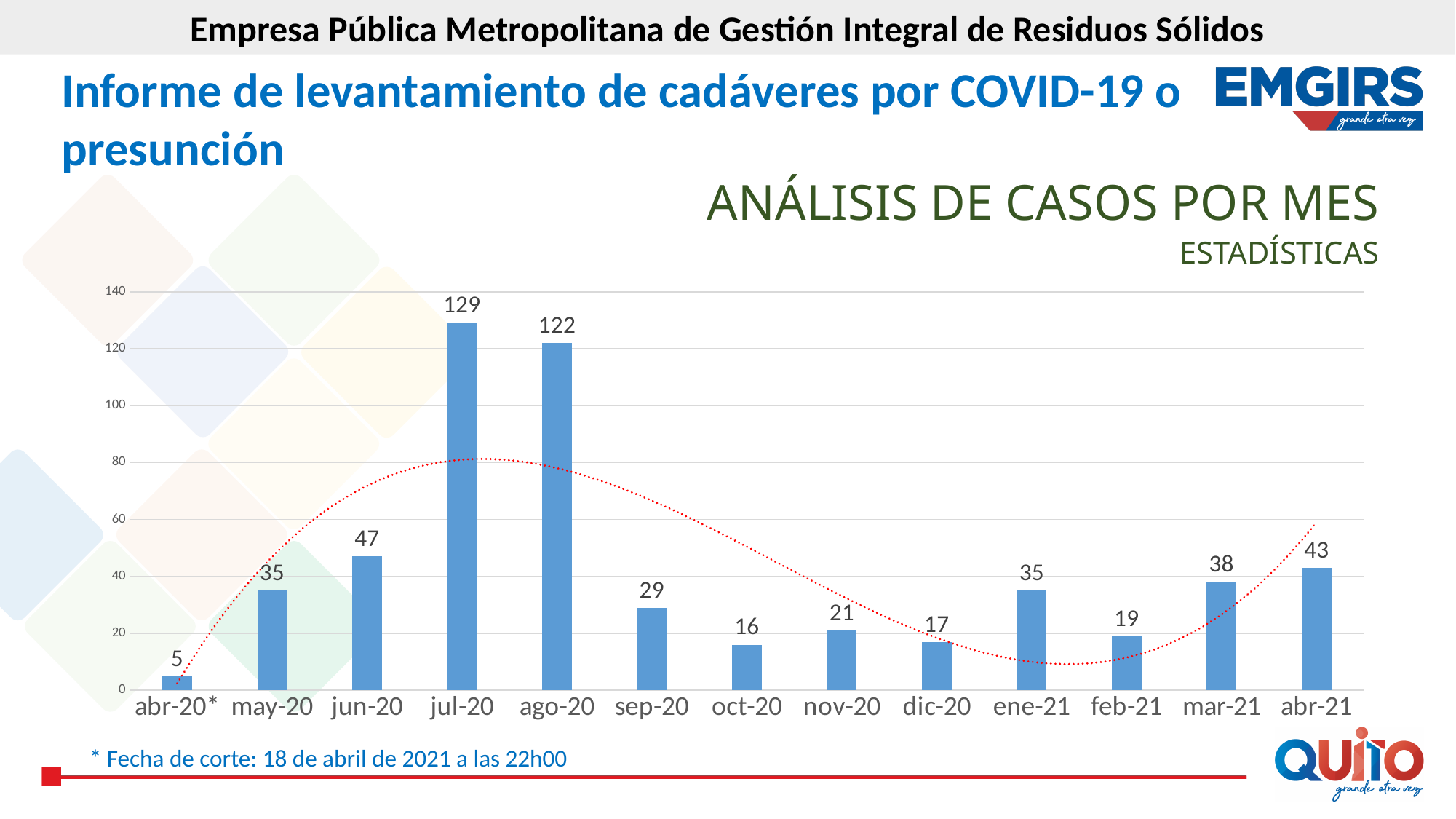
What kind of chart is shown on the slide? bar chart Which is larger, the value for jun-20 or the value for ene-21? jun-20 How many months are shown on the x axis? 13 What is the difference between the values for abr-21 and mar-21? 5 Which month has the lowest value? abr-20* What is the difference between the values for jul-20 and ago-20? 7 What is the value for abr-21? 43 What is the value for oct-20? 16 Which month has the highest value? jul-20 Is the value for ago-20 greater or less than 100? greater What is the value for jul-20? 129 Do the values rise or fall from jul-20 to dic-20? fall